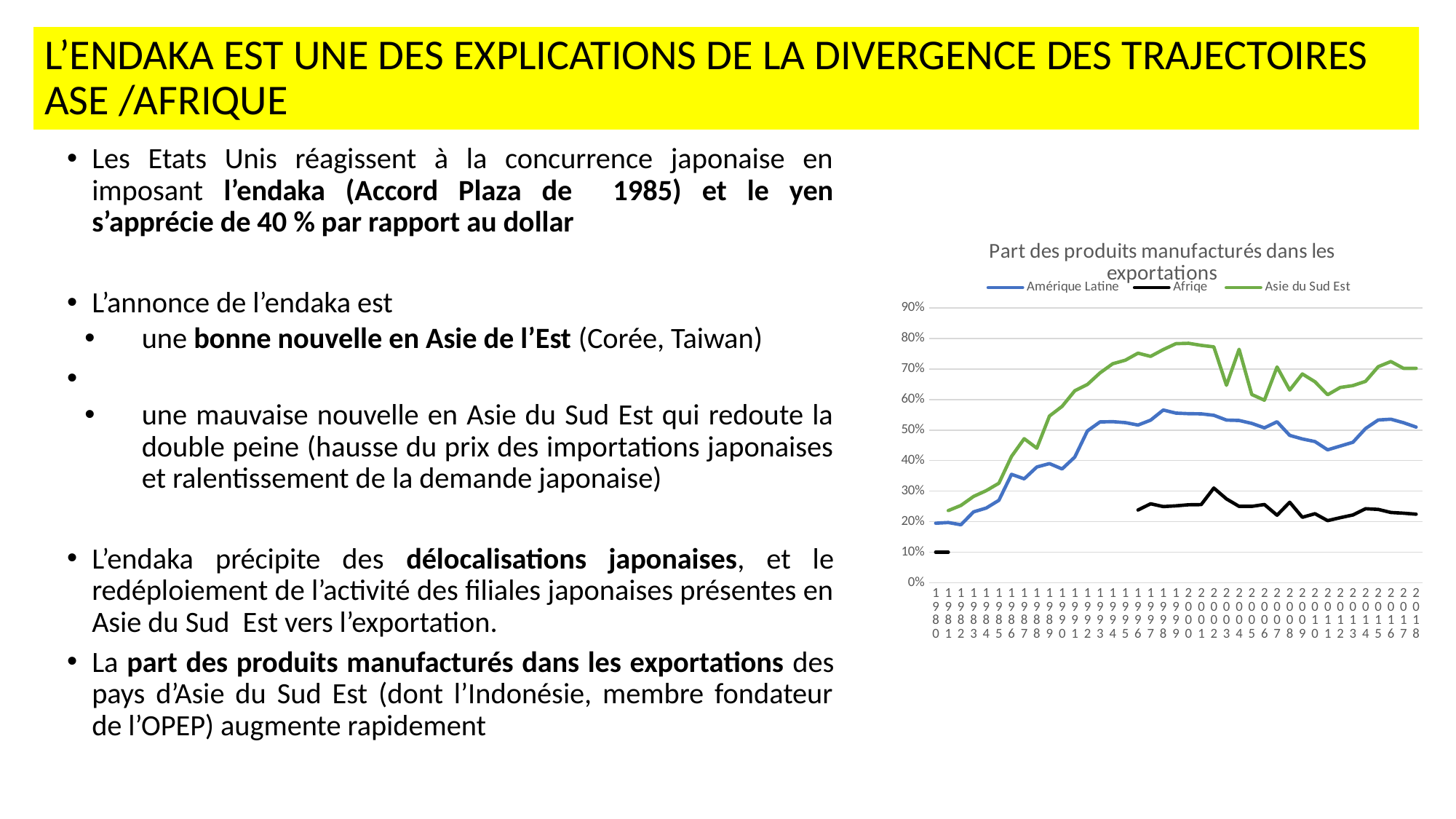
Is the value for Amérique Latine in 2013 greater or less than 50%? less Is the value for Afrique in 2018 greater or less than 30%? less What kind of chart is shown on the slide? line chart What is the title of the chart? Part des produits manufacturés dans les exportations Does the Asie du Sud Est series rise or fall between 1980 and 2000? rise Which series has the highest value in 2000? Asie du Sud Est Is the value for Asie du Sud Est in 2000 greater or less than 70%? greater In 2010, which is larger: the value for Asie du Sud Est or the value for Amérique Latine? Asie du Sud Est Which colour is used for the Afrique series in the chart? black Which series has the lowest value in 2018? Afrique How many series does the chart legend list? 3